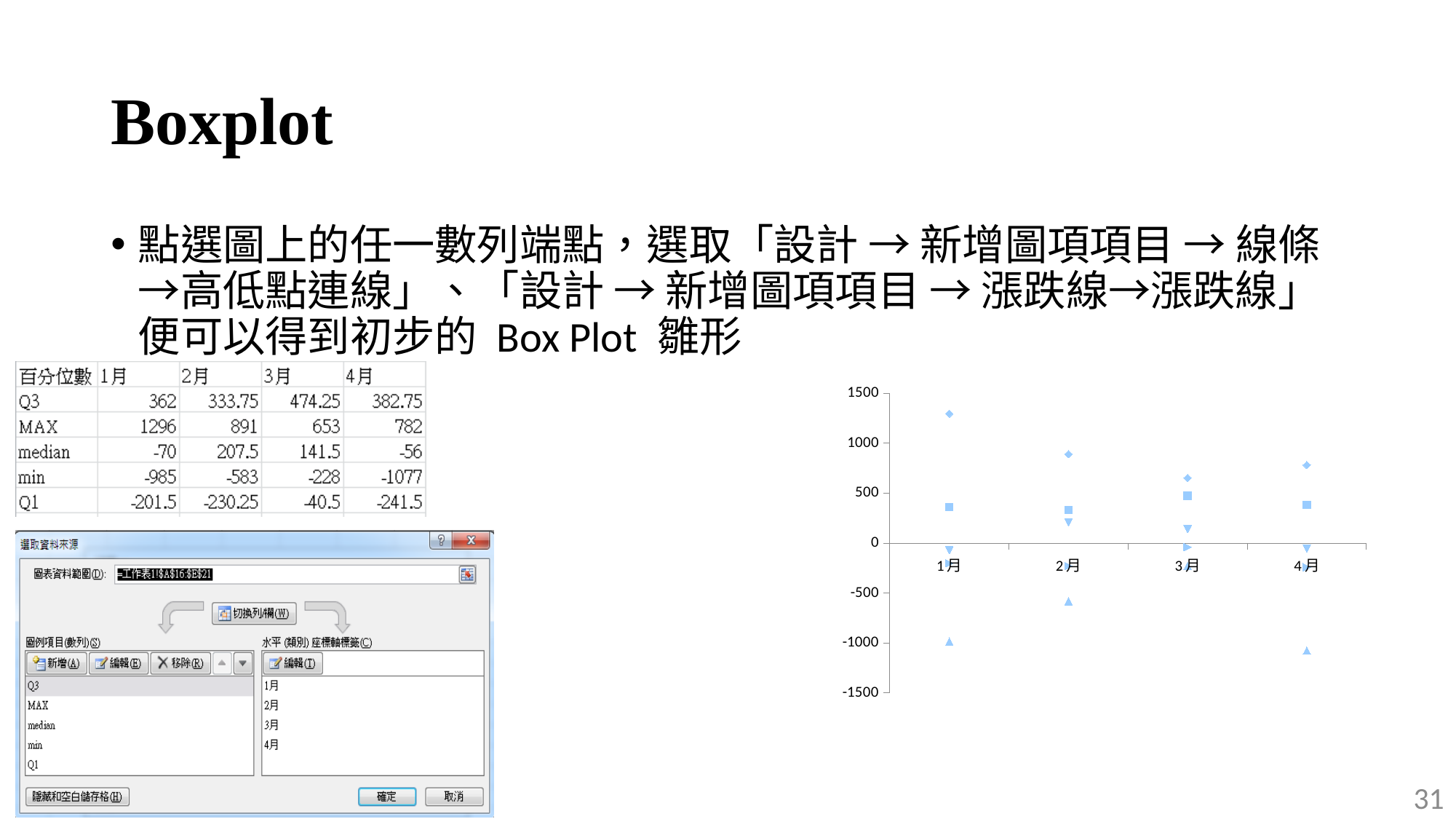
Is the highest point for 2月 greater or less than 1000? less Which category has a higher top point, 1月 or 2月? 1月 What kind of chart is shown on the right side of the slide? scatter chart What are the category labels on the x axis of the chart? 1月, 2月, 3月, 4月 Which category has the highest plotted point in the chart? 1月 Is the highest point for 1月 greater or less than 1000? greater Is the highest point for 3月 greater or less than 500? greater How many categories are shown on the x axis of the chart? 4 Which category has the lowest plotted point in the chart? 4月 What is the highest tick value shown on the chart's y axis? 1500